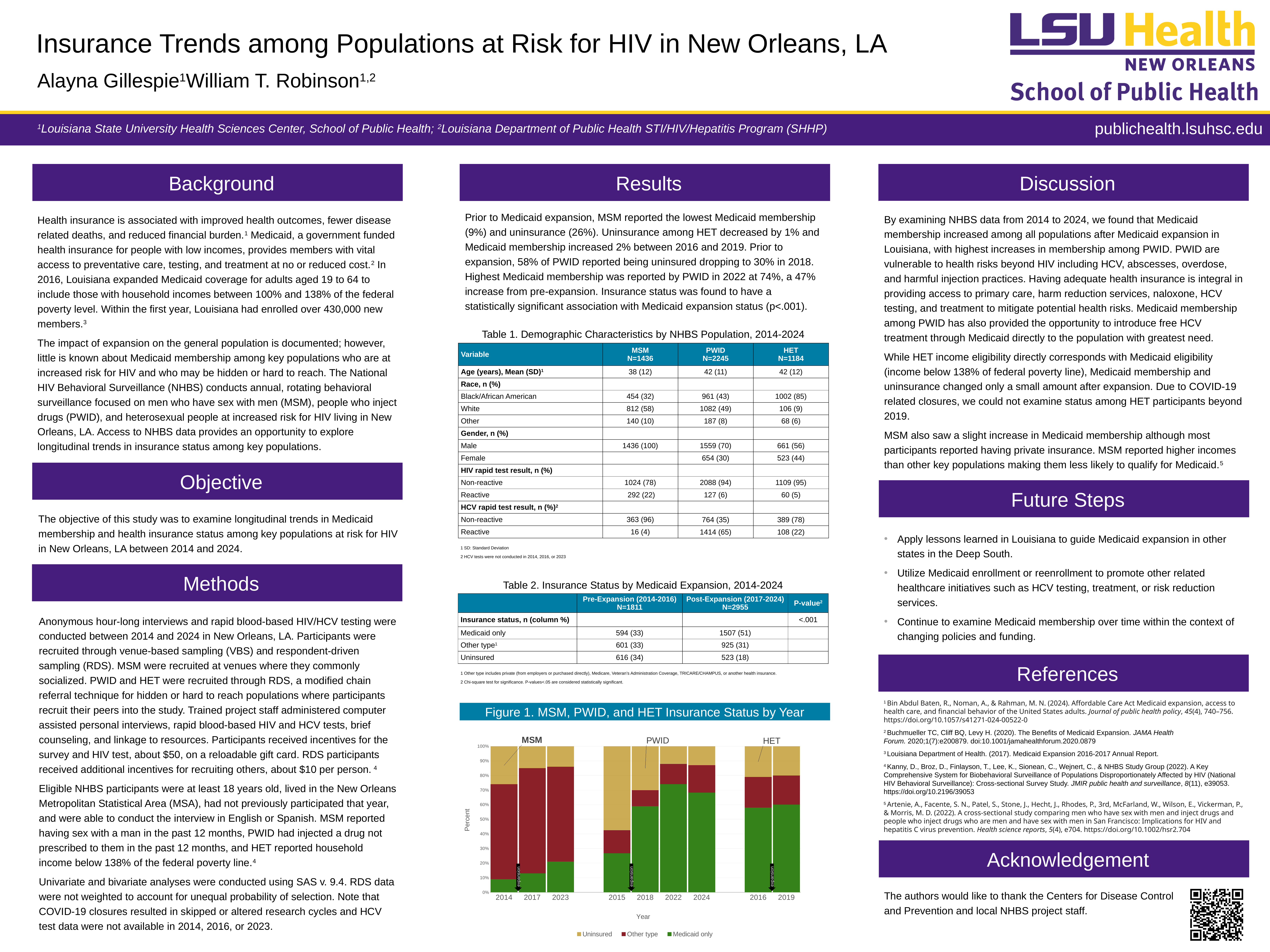
In Figure 1, which has the larger Medicaid only share: PWID in 2022 or MSM in 2023? PWID in 2022 In Figure 1, does the Medicaid only share for MSM rise or fall from 2014 to 2023? rise In Figure 1, is the Medicaid only share for HET in 2016 greater or less than 40%? greater In Figure 1, is the Medicaid only share for MSM in 2014 greater or less than 20%? less In Figure 1, is the Medicaid only share for PWID in 2022 greater or less than 60%? greater How many series does the legend of Figure 1 list? 3 How many years are shown for the PWID group in Figure 1? 4 What is the label on the y axis of Figure 1? Percent How many bars are plotted in Figure 1 in total? 9 Which insurance categories are listed in the legend of Figure 1? Uninsured, Other type, Medicaid only What kind of chart is Figure 1? Stacked bar chart